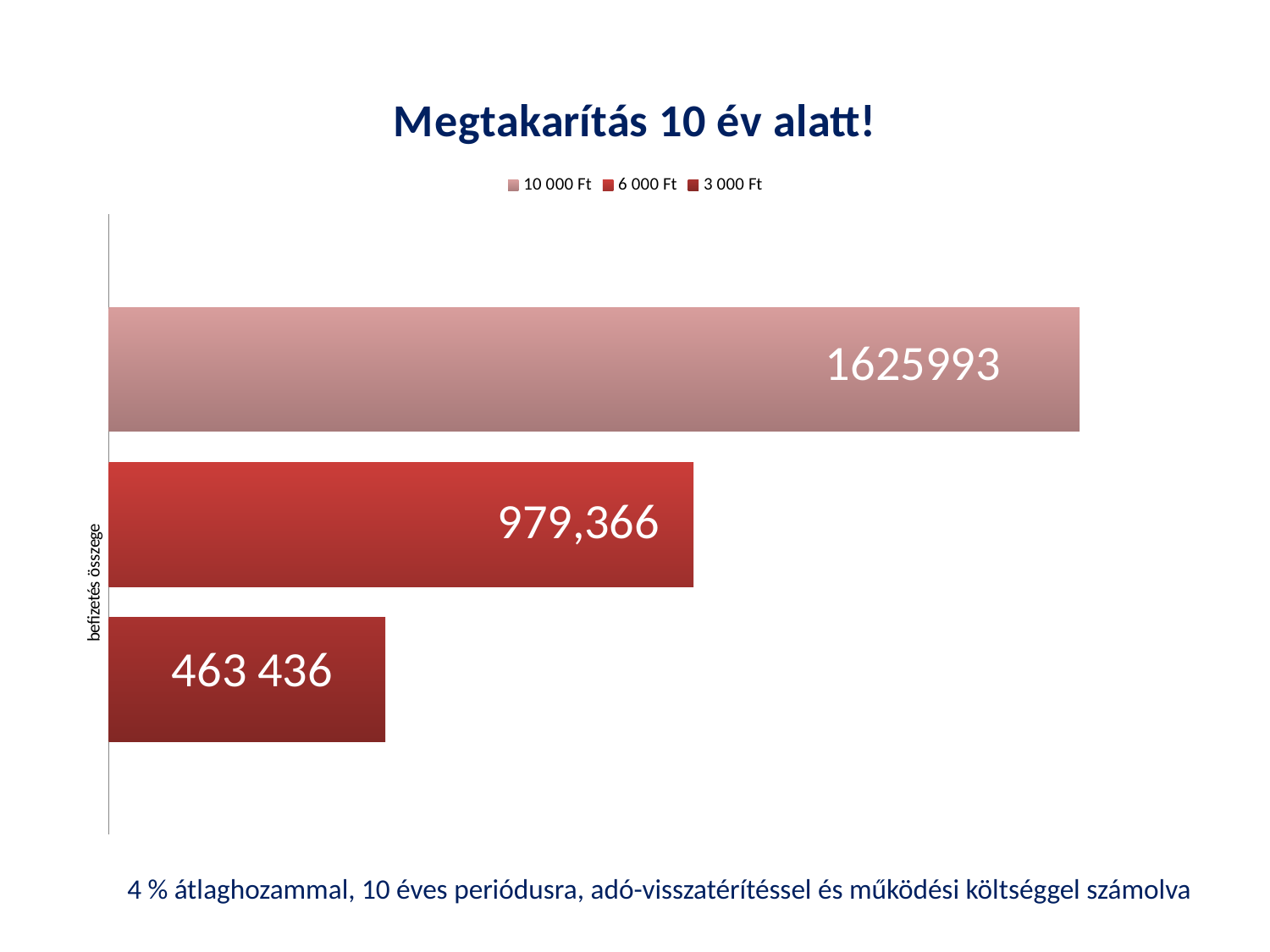
Which series has the highest value? 10 000 Ft How many series does the legend list? 3 What is the difference between the 6 000 Ft value and the 3 000 Ft value? 515930 How many bars are plotted in the chart? 3 Which series has the lowest value? 3 000 Ft Which is larger, the value for 6 000 Ft or the value for 3 000 Ft? 6 000 Ft What is the difference between the 10 000 Ft value and the 6 000 Ft value? 646627 What is the value shown for the 10 000 Ft series? 1625993 What kind of chart is shown on the slide? Bar chart What is the value shown for the 3 000 Ft series? 463 436 What is the value shown for the 6 000 Ft series? 979,366 What is the title of the chart? Megtakarítás 10 év alatt!